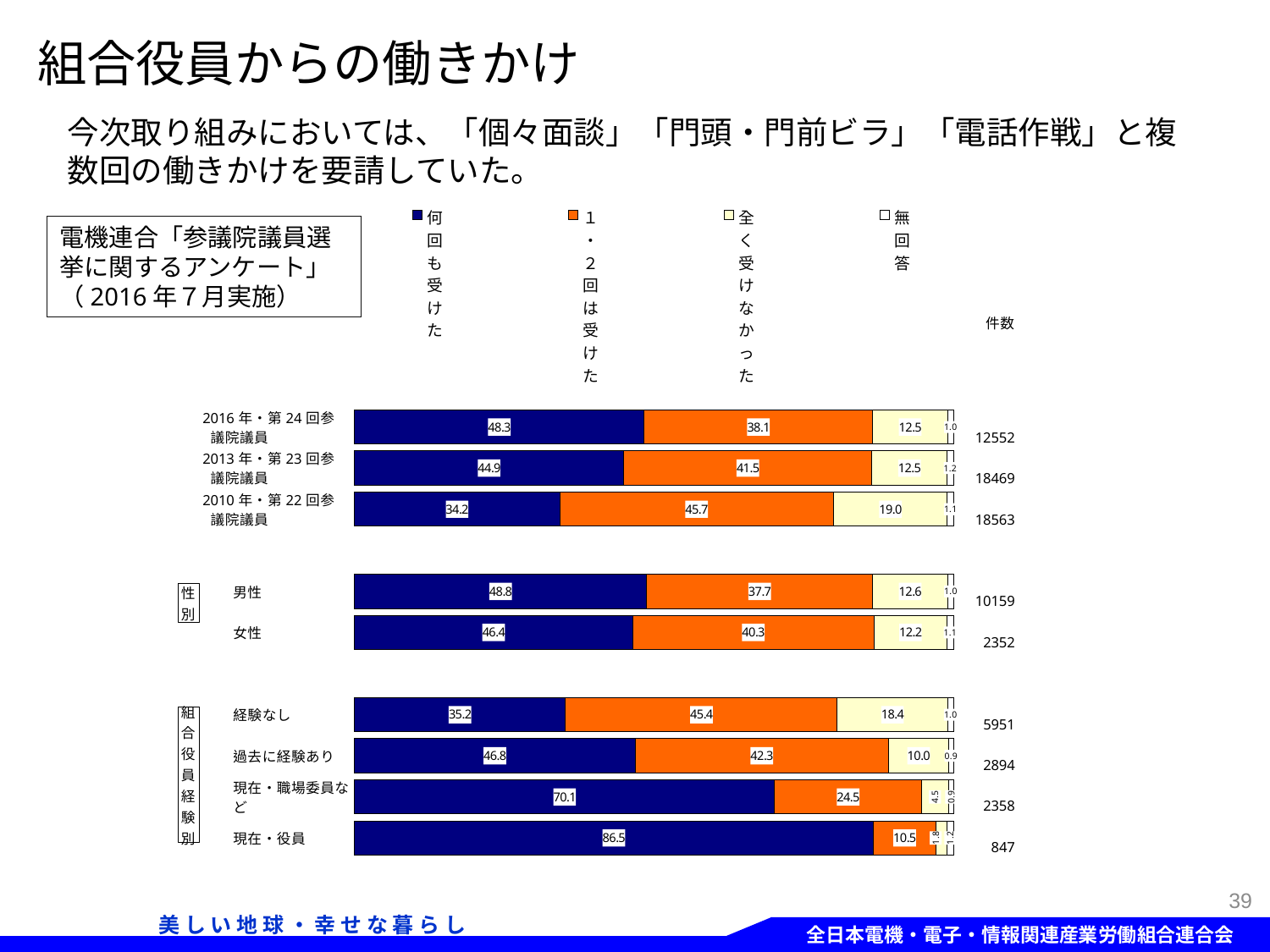
What is the value of 無回答 for 過去に経験あり? 0.9 How many categories (bars) are plotted in the chart? 9 How many series does the legend list? 4 What is the value of 全く受けなかった for 経験なし? 18.4 What is the value of 1・2回は受けた for 2010年・第22回参議院議員? 45.7 What is the 件数 (number of cases) for 女性? 2352 What is the value of 何回も受けた for 2016年・第24回参議院議員? 48.3 Which category has the highest value for 何回も受けた? 現在・役員 What is the difference between the 何回も受けた values for 男性 and 女性? 2.4 Which category has the lowest value for 何回も受けた? 2010年・第22回参議院議員 Which is larger, the 1・2回は受けた value for 2013年・第23回参議院議員 or for 2016年・第24回参議院議員? 2013年・第23回参議院議員 What kind of chart is shown on the slide? stacked bar chart